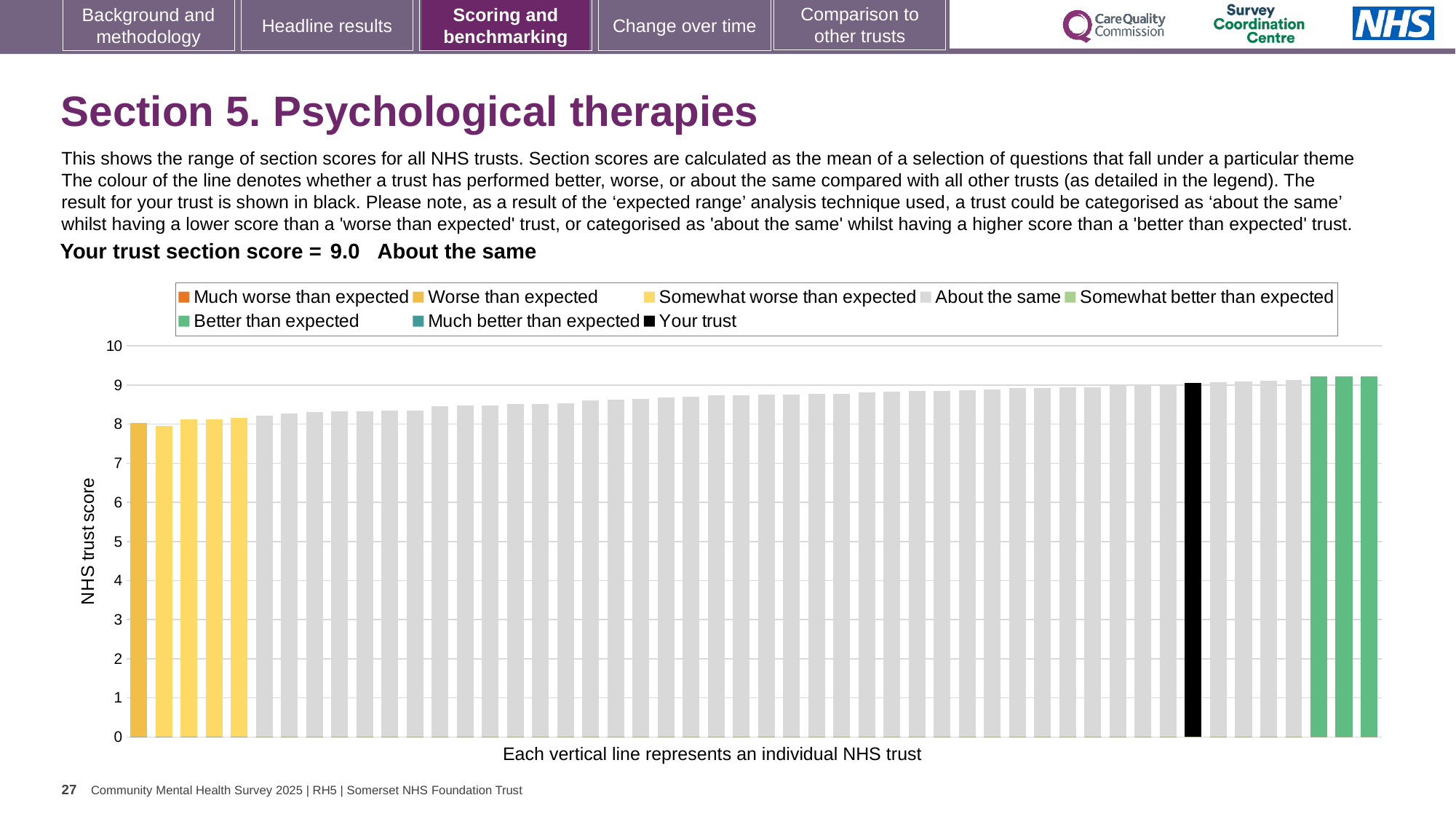
What kind of chart is shown on the slide? bar chart How many bars are coloured green (Better than expected)? 3 Which is larger: the black 'Your trust' bar or the leftmost bar in the chart? Your trust How many entries does the chart legend list? 8 Do the bar values rise or fall from left to right across the chart? rise Is the value of the black 'Your trust' bar greater or less than 8? greater What is the trust's section score for Section 5, Psychological therapies? 9.0 Is the value of the lowest bar in the chart greater or less than 7? greater Which legend category do the three tallest bars belong to? Better than expected What does each vertical line in the chart represent, according to the x-axis label? an individual NHS trust Which category is the trust's section score placed in? About the same What is the title of the vertical axis? NHS trust score